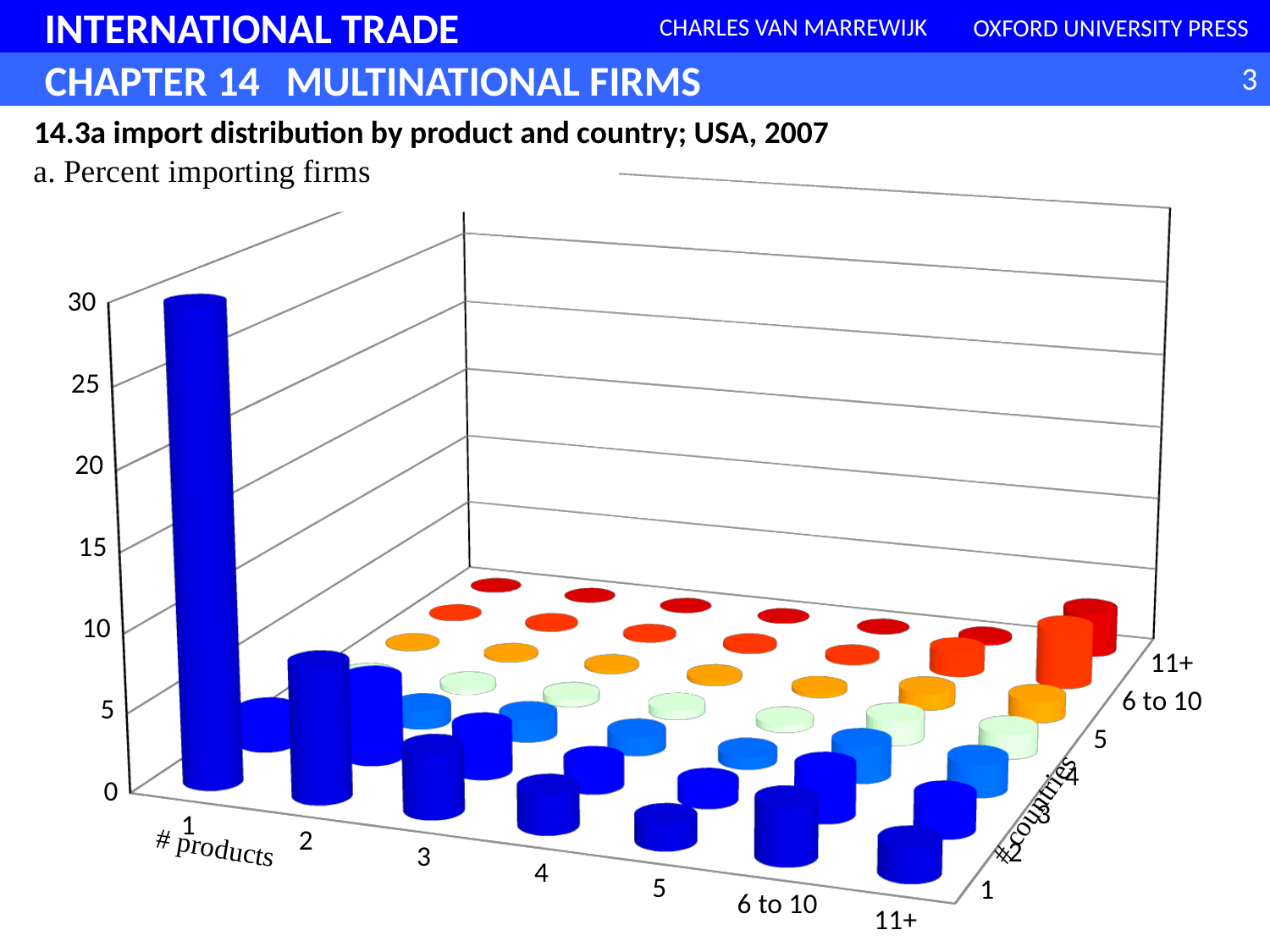
Is the value for 1 product and 1 country greater or less than 25? greater Which is larger: the value for 1 product and 1 country, or the value for 2 products and 1 country? 1 product and 1 country Is the value for 2 products and 1 country greater or less than 10? less What quantity does the vertical axis of the chart measure, according to the subtitle? Percent importing firms Which is larger: the value for 1 product and 1 country, or the value for 11+ products and 11+ countries? 1 product and 1 country How many categories are shown on the # products axis? 7 What is the title of the chart on the slide? 14.3a import distribution by product and country; USA, 2007 How many categories are shown on the # countries axis? 7 Which combination of number of products and number of countries has the highest percent of importing firms? 1 product, 1 country Is the value for 11+ products and 11+ countries greater or less than 10? less What kind of chart is shown on the slide? bar chart What is the highest value labelled on the vertical axis? 30